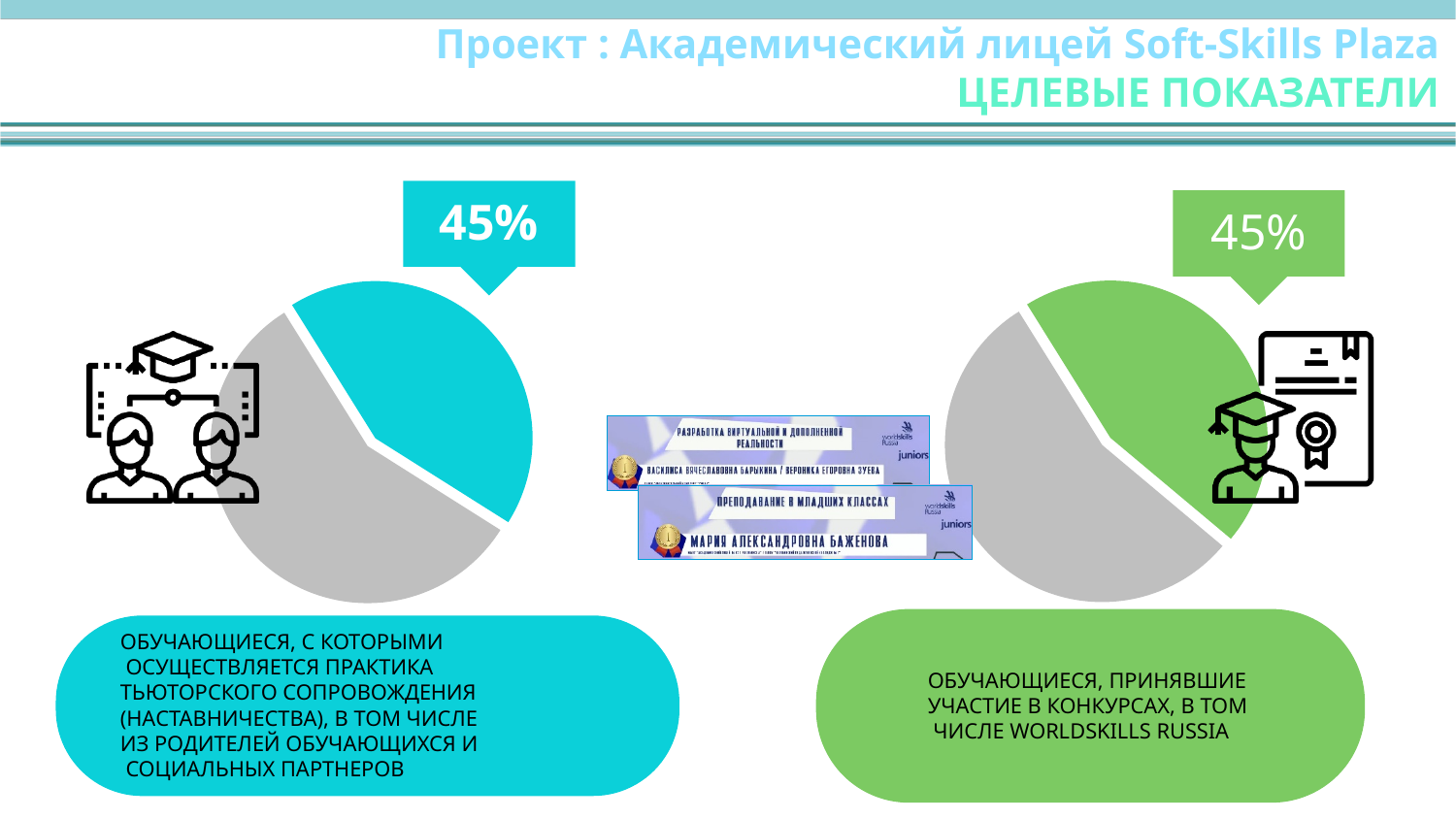
What colour is the highlighted slice in the right pie chart? green How many slices does the left pie chart have? 2 How many slices does the right pie chart have? 2 In the left pie chart, which slice is larger: the cyan slice or the grey slice? the grey slice Which indicator does the right pie chart describe, according to the caption below it? Обучающиеся, принявшие участие в конкурсах, в том числе WorldSkills Russia In the right pie chart, what percentage is shown for the highlighted (green) slice? 45% In the right pie chart, which slice is larger: the green slice or the grey slice? the grey slice In the left pie chart, what percentage is shown for the highlighted (cyan) slice? 45% What kind of chart is shown on the left side of the slide? pie chart Is the highlighted slice in the left pie chart greater or less than 50% of the pie? less What kind of chart is shown on the right side of the slide? pie chart